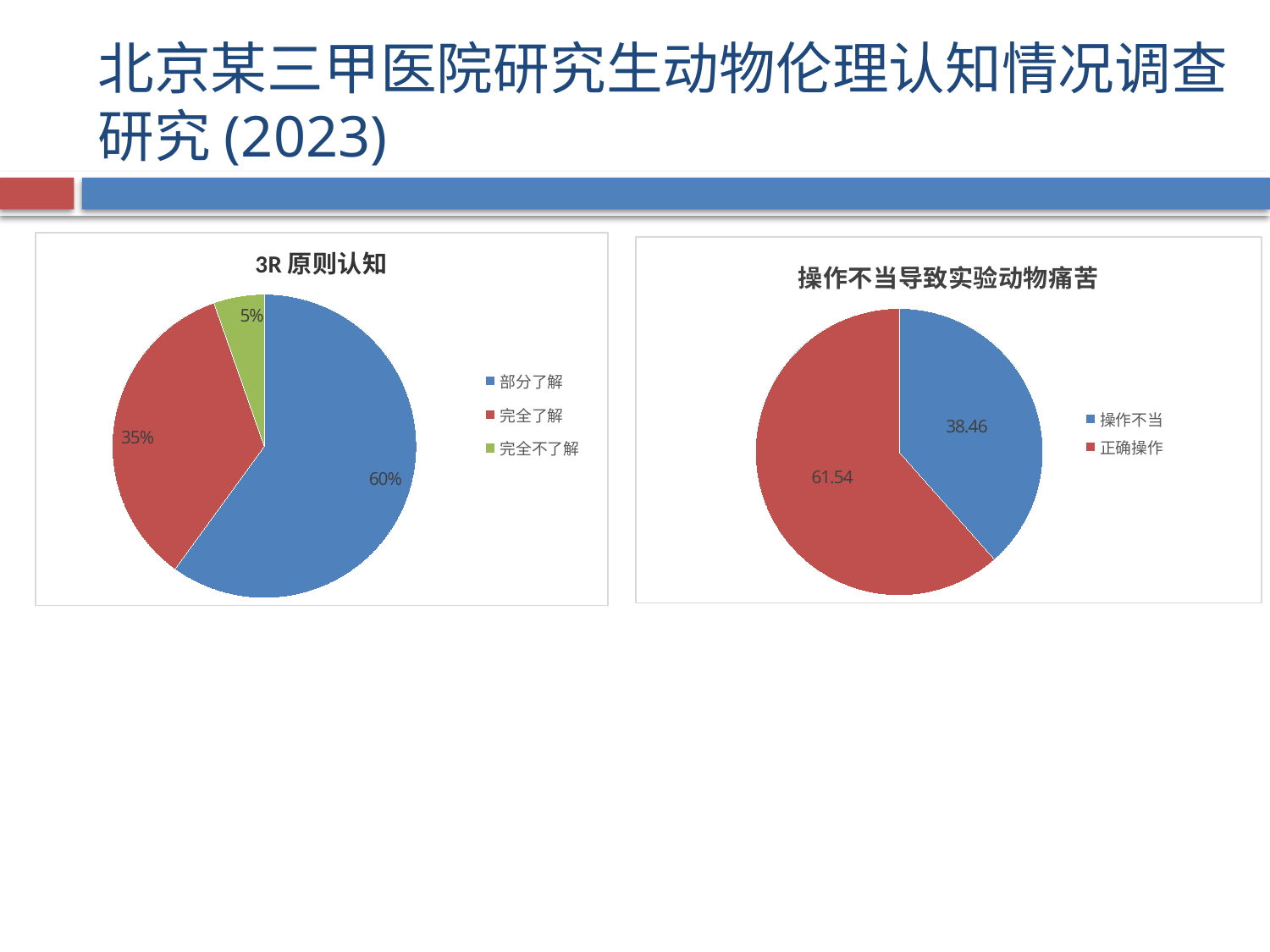
In the "操作不当导致实验动物痛苦" chart, what is the value for 操作不当? 38.46 In the "3R 原则认知" chart, how many categories are shown? 3 In the "操作不当导致实验动物痛苦" chart, what is the value for 正确操作? 61.54 In the "3R 原则认知" chart, what is the value for 完全不了解? 5% In the "3R 原则认知" chart, what is the difference between 部分了解 and 完全了解? 25% What kind of chart is the "操作不当导致实验动物痛苦" chart? Pie chart In the "3R 原则认知" chart, which category has the largest slice? 部分了解 In the "3R 原则认知" chart, which category has the smallest slice? 完全不了解 In the "3R 原则认知" chart, what is the value for 完全了解? 35% In the "3R 原则认知" chart, what is the value for 部分了解? 60% In the "操作不当导致实验动物痛苦" chart, what is the difference between 正确操作 and 操作不当? 23.08 In the "操作不当导致实验动物痛苦" chart, which is larger, 操作不当 or 正确操作? 正确操作